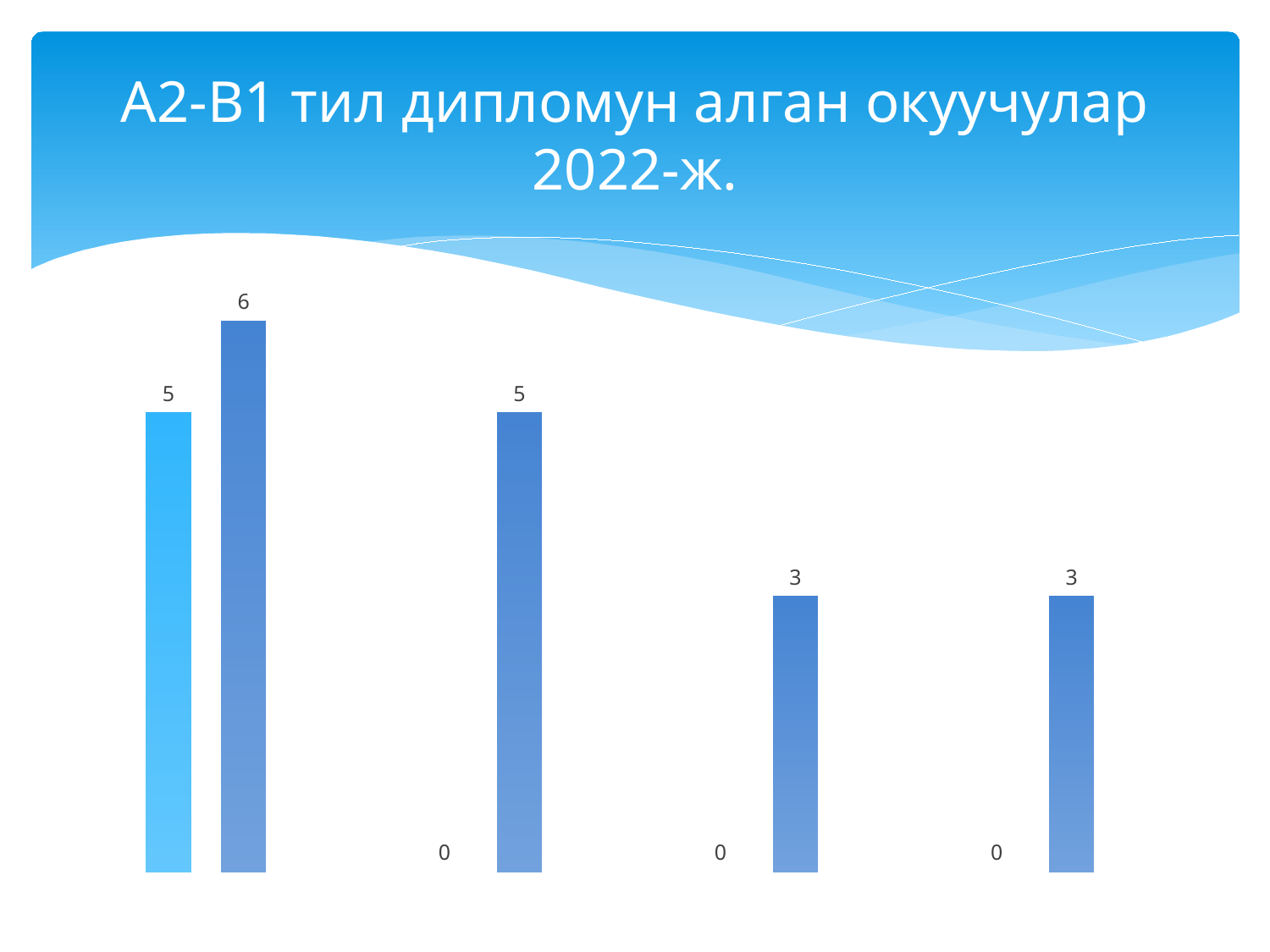
What is the value of the light blue bar in the first (leftmost) group? 5 Do the values of the darker blue bars rise or fall from left to right across the groups? fall What is the value of the darker blue bar in the first (leftmost) group? 6 What kind of chart is shown on the slide? bar chart How many groups of bars are plotted in the chart? 4 Which is larger: the darker blue bar in the first group or the darker blue bar in the second group? the first group What is the difference between the two bars in the first (leftmost) group? 1 What value is labeled for the light blue series in the second, third and fourth groups? 0 What is the value of the darker blue bar in the second group from the left? 5 What is the value of the darker blue bar in the rightmost group? 3 What is the highest value labeled on any bar in the chart? 6 What is the title of the slide chart? А2-В1 тил дипломун алган окуучулар 2022-ж.